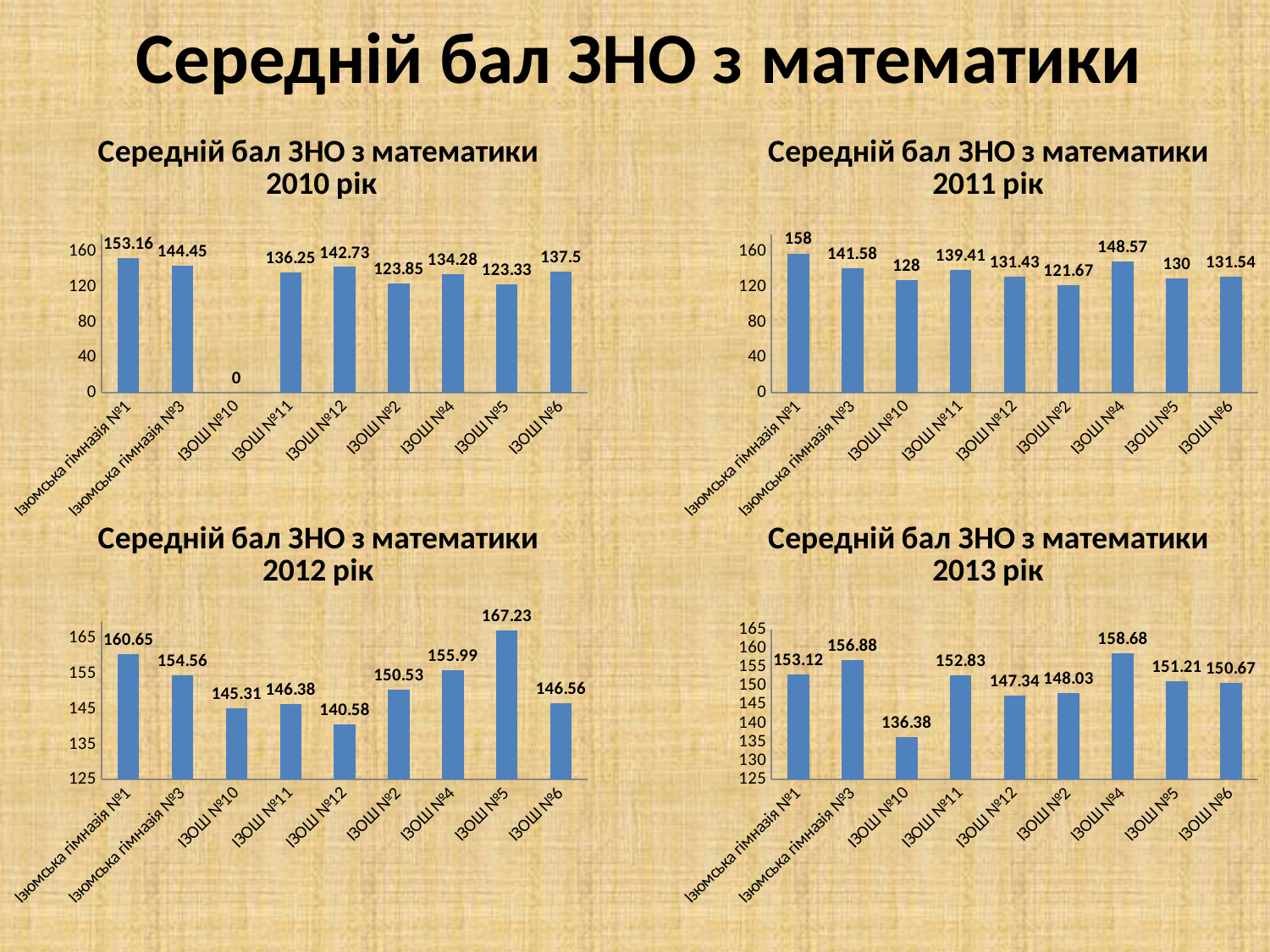
In the 2010 chart (top left), what is the value for ІЗОШ №10? 0 In the 2010 chart (top left), what is the difference between the values for Ізюмська гімназія №1 and ІЗОШ №5? 29.83 In the 2010 chart (top left), what is the value for ІЗОШ №12? 142.73 What kind of chart is the 2012 chart (bottom left)? Bar chart In the 2012 chart (bottom left), which category has the lowest value? ІЗОШ №12 In the 2011 chart (top right), which category has the lowest value? ІЗОШ №2 How many categories are shown in the 2013 chart (bottom right)? 9 In the 2011 chart (top right), which is larger: the value for ІЗОШ №4 or the value for Ізюмська гімназія №3? ІЗОШ №4 In the 2012 chart (bottom left), what is the value for ІЗОШ №5? 167.23 In the 2011 chart (top right), which category has the highest value? Ізюмська гімназія №1 In the 2013 chart (bottom right), which category has the highest value? ІЗОШ №4 In the 2013 chart (bottom right), what is the value for ІЗОШ №10? 136.38